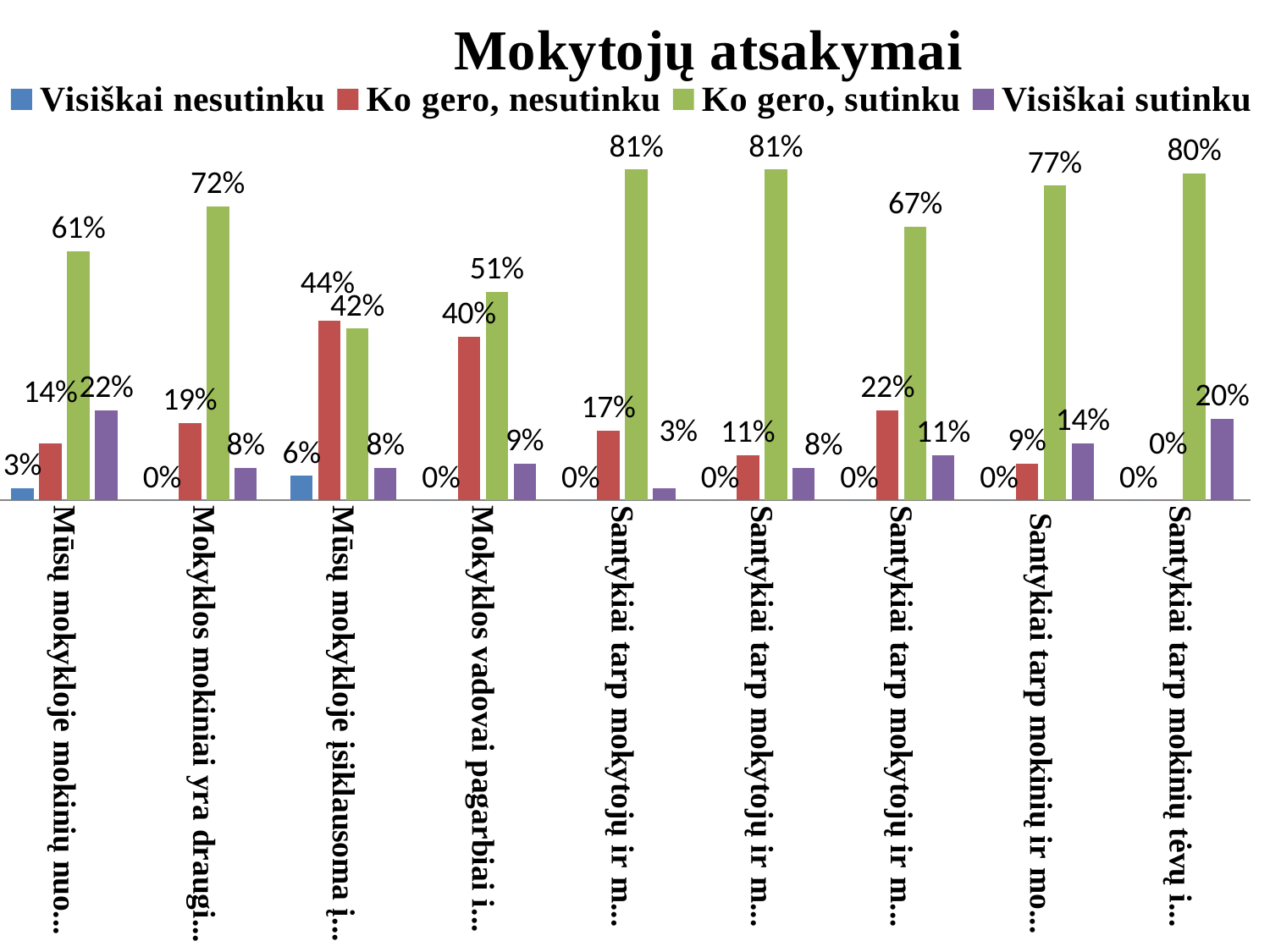
How many categories are shown along the x axis? 9 What is the value of "Ko gero, sutinku" for the first category (Mūsų mokykloje mokinių nuo...)? 61% What is the difference between the "Ko gero, sutinku" value for the second category (Mokyklos mokiniai yra draugi...) and the first category (Mūsų mokykloje mokinių nuo...)? 11% Which category has the lowest "Ko gero, sutinku" value? Mūsų mokykloje įsiklausoma į... (third category) What is the value of "Visiškai sutinku" for the last category (Santykiai tarp mokinių tėvų i...)? 20% What is the title of the chart? Mokytojų atsakymai What is the value of "Visiškai nesutinku" for the first category (Mūsų mokykloje mokinių nuo...)? 3% For the third category (Mūsų mokykloje įsiklausoma į...), which is larger: "Ko gero, nesutinku" or "Ko gero, sutinku"? Ko gero, nesutinku What is the value of "Ko gero, nesutinku" for the third category (Mūsų mokykloje įsiklausoma į...)? 44% Which series is shown in green? Ko gero, sutinku What kind of chart is shown on the slide? bar chart How many series does the legend list? 4